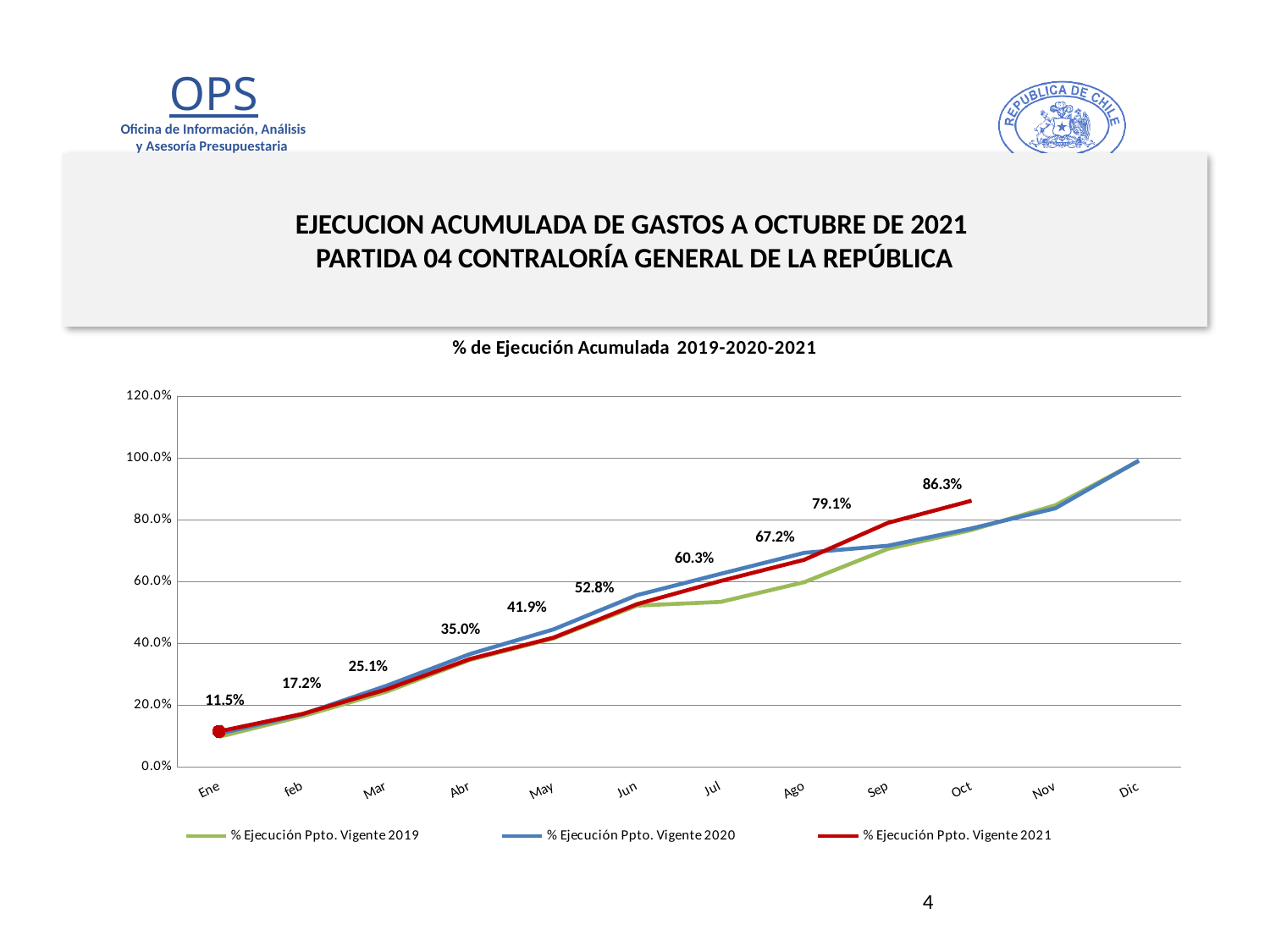
What is the difference between the % Ejecución Ppto. Vigente 2021 values for Oct and Sep? 7.2% Do the values for % Ejecución Ppto. Vigente 2021 rise or fall from Ene to Oct? rise What is the value for % Ejecución Ppto. Vigente 2021 in Oct? 86.3% How many series does the legend list? 3 Which month has the lowest labelled value for % Ejecución Ppto. Vigente 2021? Ene How many months are shown along the x axis? 12 What is the value for % Ejecución Ppto. Vigente 2021 in Abr? 35.0% Is the value for % Ejecución Ppto. Vigente 2020 in Dic greater or less than 80.0%? greater In Sep, which series has the higher value: % Ejecución Ppto. Vigente 2021 or % Ejecución Ppto. Vigente 2020? % Ejecución Ppto. Vigente 2021 What kind of chart is shown on the slide? line chart What is the value for % Ejecución Ppto. Vigente 2021 in Jul? 60.3% Which month has the highest labelled value for % Ejecución Ppto. Vigente 2021? Oct